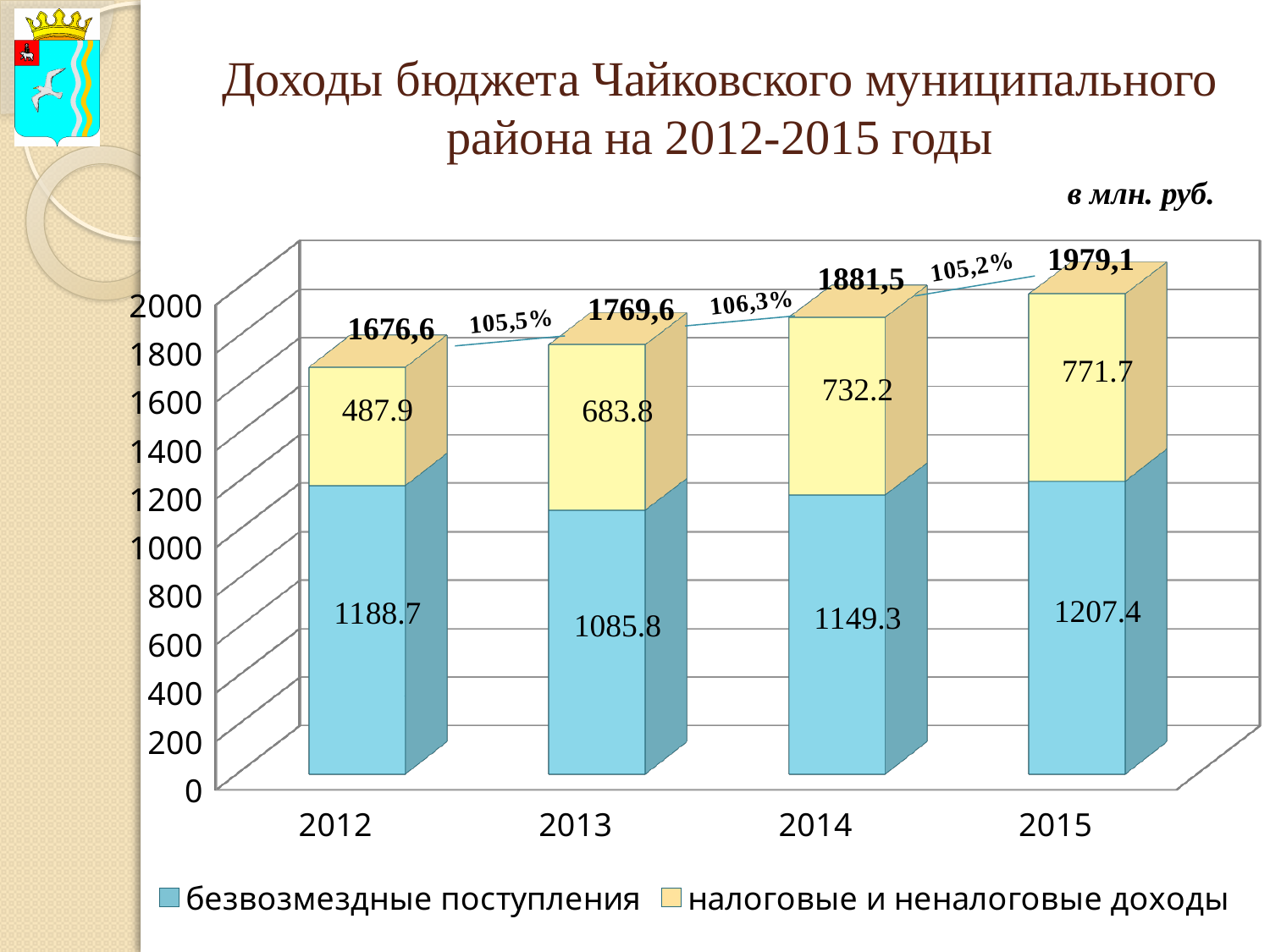
What is the value of безвозмездные поступления for 2013? 1085.8 What is the difference between налоговые и неналоговые доходы in 2013 and in 2012? 195.9 What is the total labelled above the stacked bar for 2014? 1881,5 How many series does the legend list? 2 Which is larger: безвозмездные поступления in 2012 or in 2014? 2012 What is the value of налоговые и неналоговые доходы for 2015? 771.7 Which year has the lowest value of безвозмездные поступления? 2013 What kind of chart is shown on the slide? stacked bar chart What growth percentage is shown between 2013 and 2014? 106,3% How many years are shown on the x axis? 4 Do the total budget revenues rise or fall from 2012 to 2015? rise Which year has the highest value of налоговые и неналоговые доходы? 2015